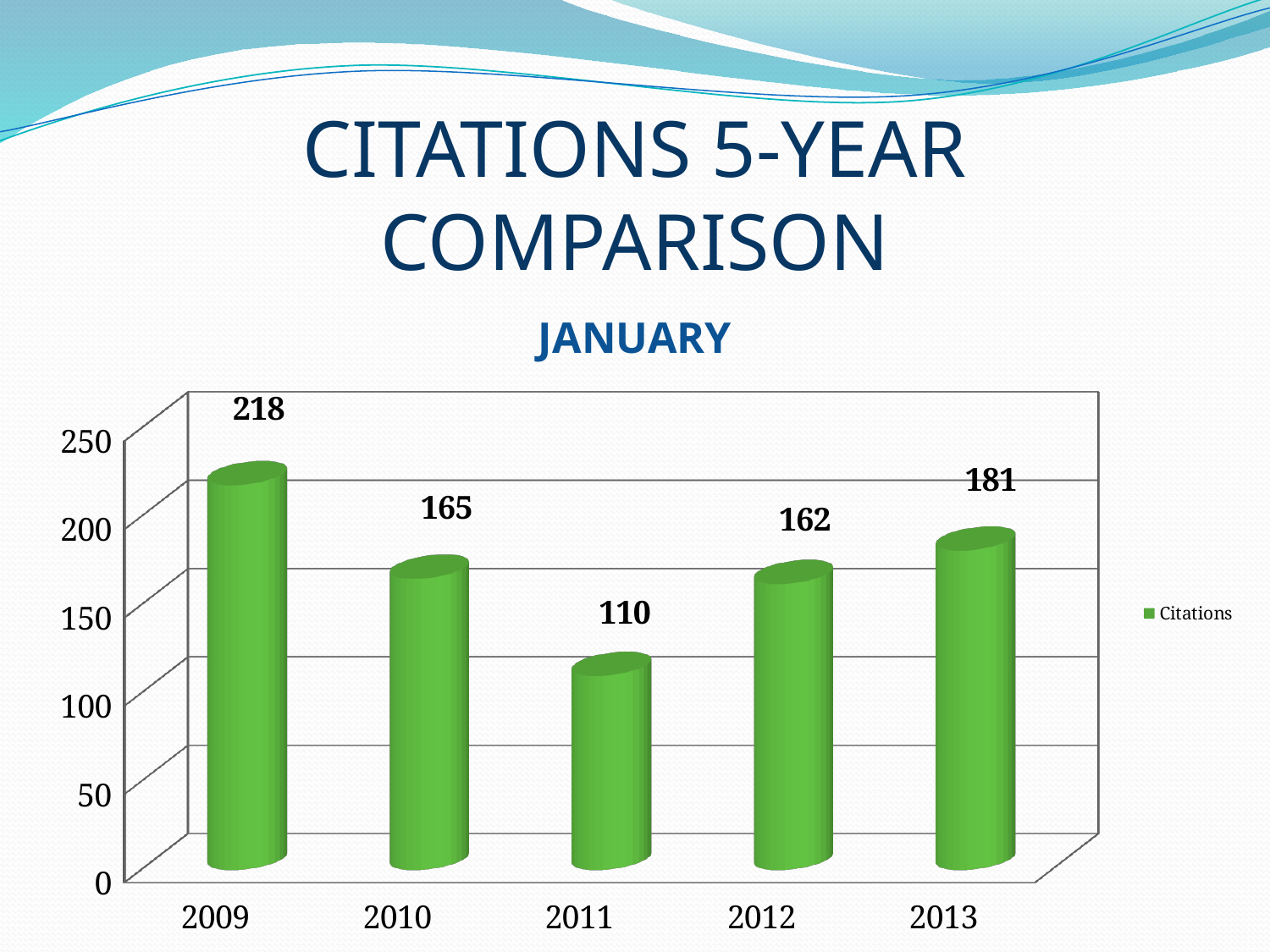
What is the number of citations for 2009? 218 What is the number of citations for 2011? 110 Which year has the highest number of citations? 2009 How many years are shown on the x axis? 5 Which year has more citations, 2010 or 2013? 2013 Which year has the lowest number of citations? 2011 What is the number of citations for 2013? 181 What is the difference in citations between 2009 and 2011? 108 What series name is listed in the legend? Citations What kind of chart is shown on the slide? Bar chart Is the value for 2012 greater or less than 150? greater What is the difference in citations between 2013 and 2012? 19